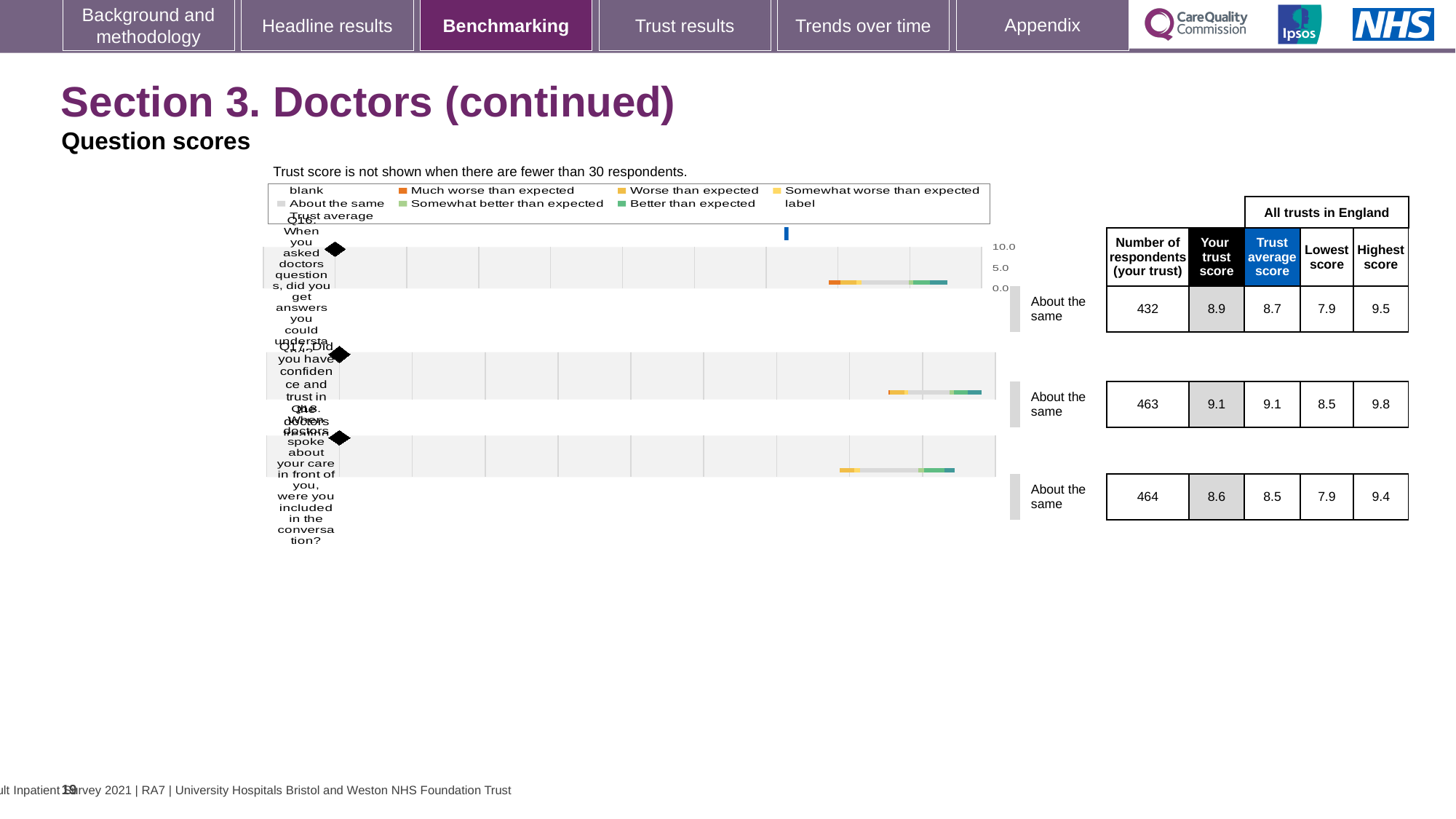
For Q16, what is the difference between 'Your trust score' and the trust average score? 0.2 What is the trust average score for Q18 (When doctors spoke about your care in front of you, were you included in the conversation)? 8.5 For Q18, which is larger: 'Your trust score' or the trust average score? Your trust score Which question has the highest 'Your trust score'? Q17 Which question has the lowest 'Your trust score'? Q18 What is the 'Your trust score' for Q17 (Did you have confidence and trust in the doctors treating you)? 9.1 According to the note above the chart, when is the trust score not shown? When there are fewer than 30 respondents How many questions (categories) are plotted in the chart? 3 What kind of chart is used to show the question scores on this slide? bar chart What benchmark category is shown for Q16? About the same What is the highest score across all trusts in England for Q17? 9.8 How many respondents (your trust) are shown for Q16? 432